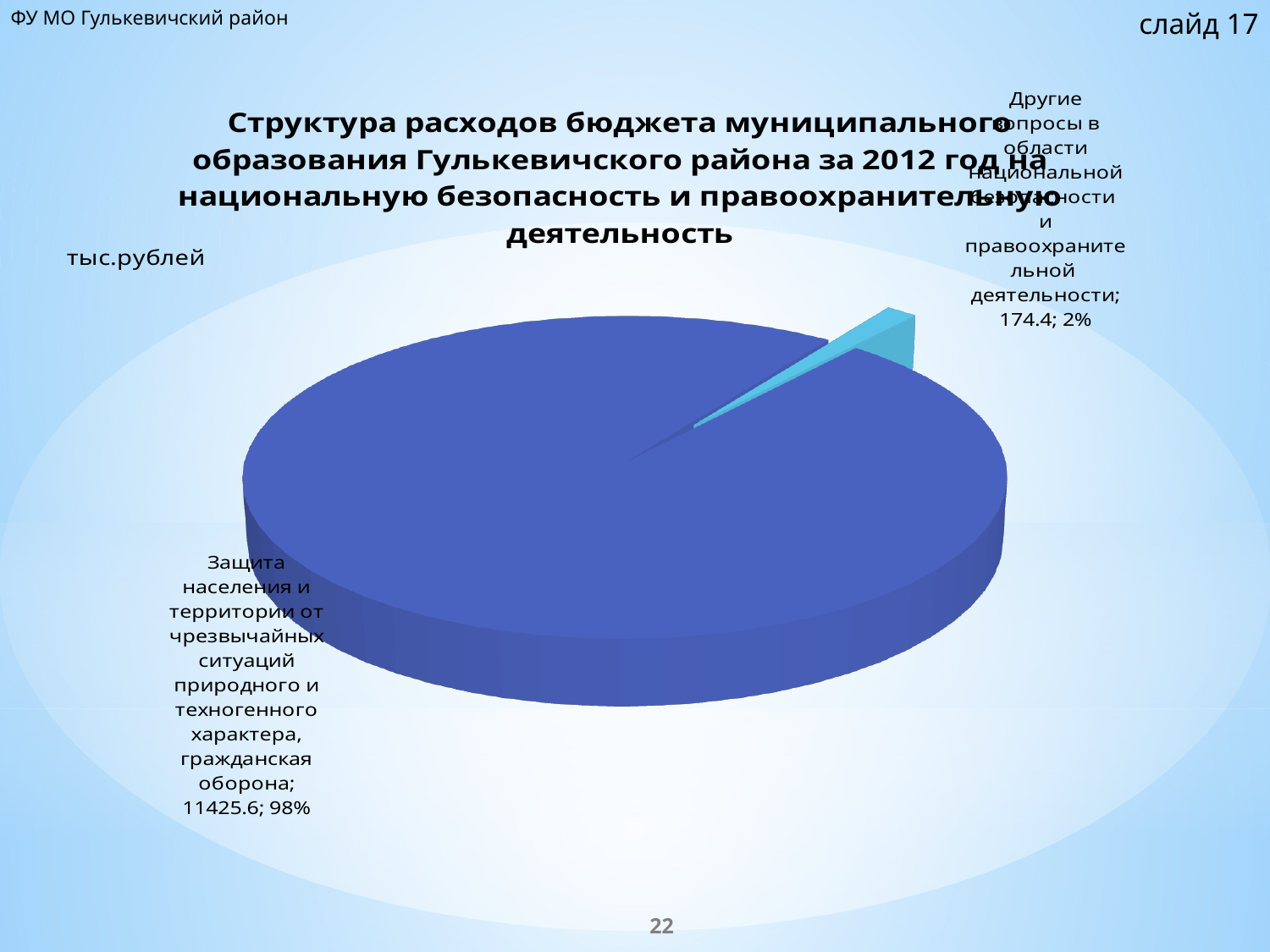
Which category has the smallest slice of the pie? Другие вопросы в области национальной безопасности и правоохранительной деятельности What kind of chart is shown on the slide? Pie chart Which is larger: the value for "Защита населения и территории от чрезвычайных ситуаций природного и техногенного характера, гражданская оборона" or for "Другие вопросы в области национальной безопасности и правоохранительной деятельности"? Защита населения и территории от чрезвычайных ситуаций природного и техногенного характера, гражданская оборона How many slices does the pie chart have? 2 What unit of measurement is indicated for the chart values? тыс.рублей What share of the pie does "Другие вопросы в области национальной безопасности и правоохранительной деятельности" represent? 2% For which year does the chart show the budget expenditure structure? 2012 What is the value for "Другие вопросы в области национальной безопасности и правоохранительной деятельности"? 174.4 What is the difference between the values for "Защита населения и территории от чрезвычайных ситуаций природного и техногенного характера, гражданская оборона" and "Другие вопросы в области национальной безопасности и правоохранительной деятельности"? 11251.2 Which category has the largest slice of the pie? Защита населения и территории от чрезвычайных ситуаций природного и техногенного характера, гражданская оборона What share of the pie does "Защита населения и территории от чрезвычайных ситуаций природного и техногенного характера, гражданская оборона" represent? 98% What is the value for "Защита населения и территории от чрезвычайных ситуаций природного и техногенного характера, гражданская оборона"? 11425.6